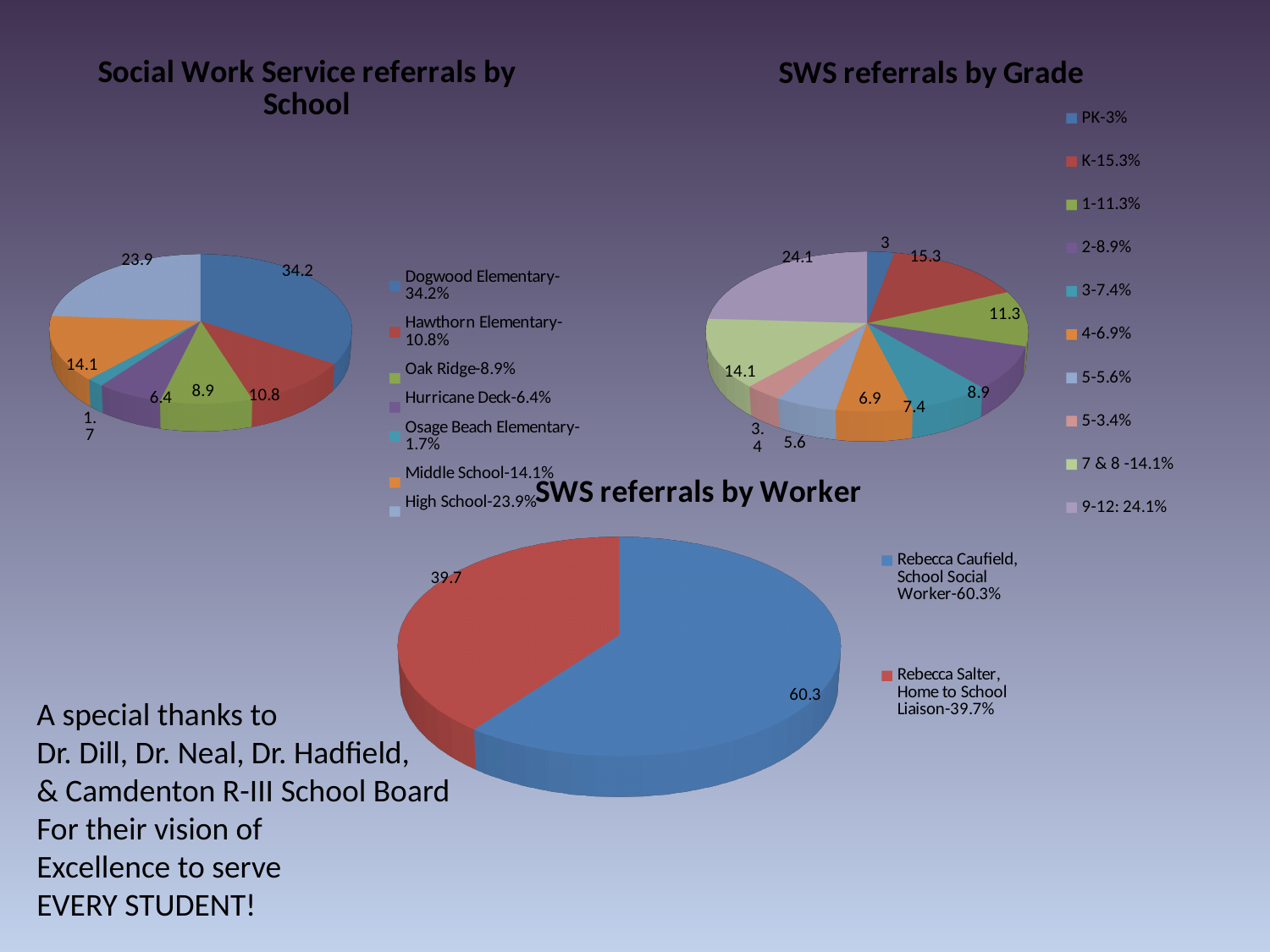
In the 'SWS referrals by Worker' chart, what share of referrals is attributed to Rebecca Salter, Home to School Liaison? 39.7% In the 'Social Work Service referrals by School' chart, which school has the smallest slice? Osage Beach Elementary In the 'Social Work Service referrals by School' chart, what is the difference between the High School and Middle School values? 9.8 In the 'SWS referrals by Grade' chart, which grade group has the largest slice? 9-12 How many legend entries does the 'SWS referrals by Grade' chart list? 10 In the 'SWS referrals by Worker' chart, what is the difference between the two workers' values? 20.6 What type of chart is 'SWS referrals by Worker'? pie chart How many categories does the 'Social Work Service referrals by School' chart show? 7 In the 'SWS referrals by Grade' chart, what is the value for grade K? 15.3 In the 'Social Work Service referrals by School' chart, what is the value for Dogwood Elementary? 34.2 In the 'SWS referrals by Grade' chart, which is larger, grade 1 or grade 2? grade 1 In the 'Social Work Service referrals by School' chart, which school has the largest slice? Dogwood Elementary